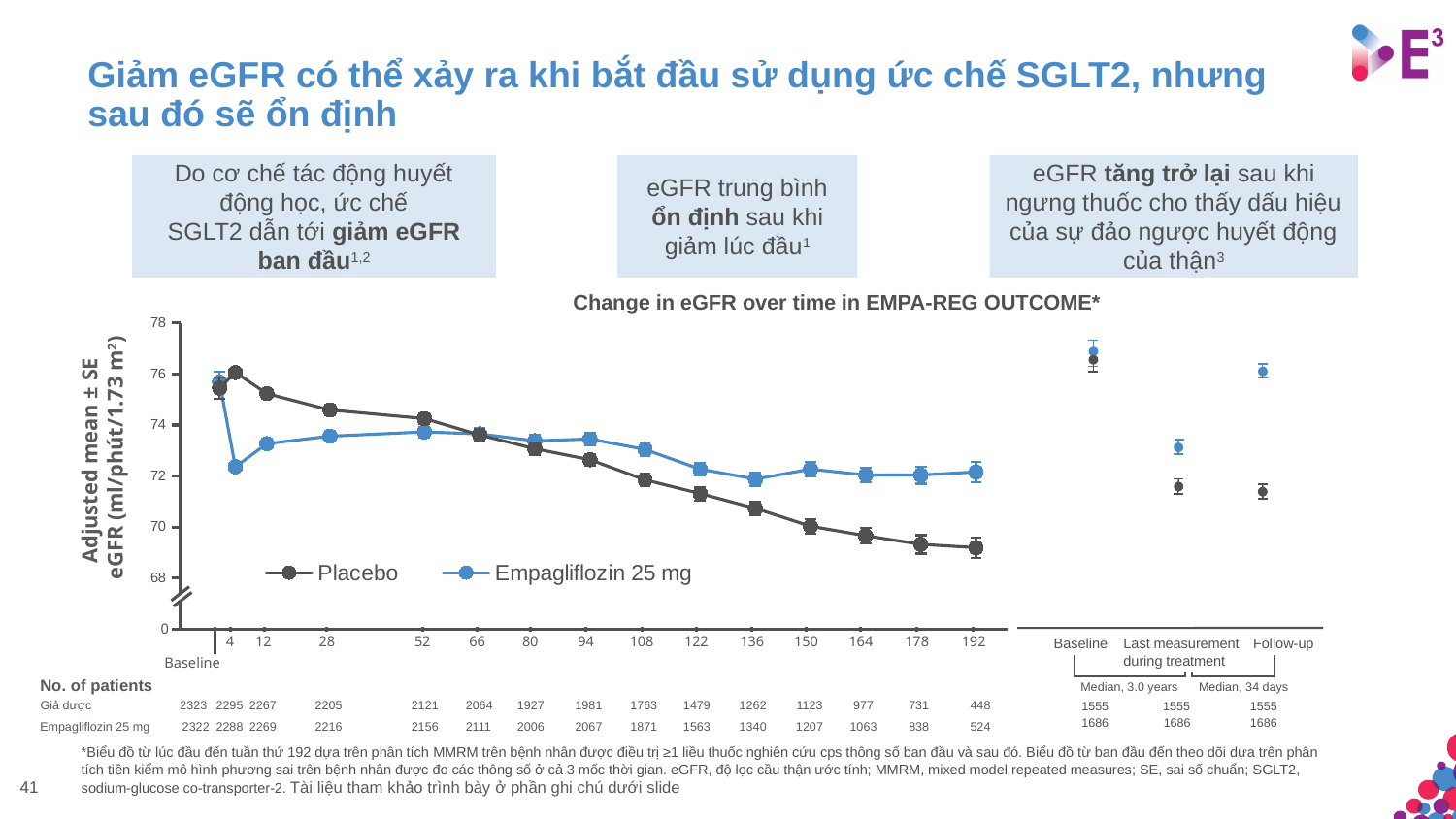
According to the 'No. of patients' row under the chart, how many Placebo patients were there at week 192? 448 In the eGFR chart, which series has the higher value at week 192, Placebo or Empagliflozin 25 mg? Empagliflozin 25 mg What is the title of the chart on the slide? Change in eGFR over time in EMPA-REG OUTCOME* In the eGFR chart, is the Placebo value at week 4 greater or less than 74? greater What are the two series shown in the eGFR chart legend? Placebo and Empagliflozin 25 mg In the eGFR chart, is the Placebo value at week 192 greater or less than 70? less In the eGFR chart, which series has the higher value at week 4, Placebo or Empagliflozin 25 mg? Placebo How many time points are labelled on the x axis from Baseline to week 192 in the eGFR chart? 15 What type of chart is used to show the change in eGFR over time in EMPA-REG OUTCOME? Line chart How many series does the legend of the eGFR chart list? 2 In the eGFR chart, is the Empagliflozin 25 mg value at week 4 greater or less than 74? less In the eGFR chart, does the Placebo series rise or fall from week 12 to week 192? fall